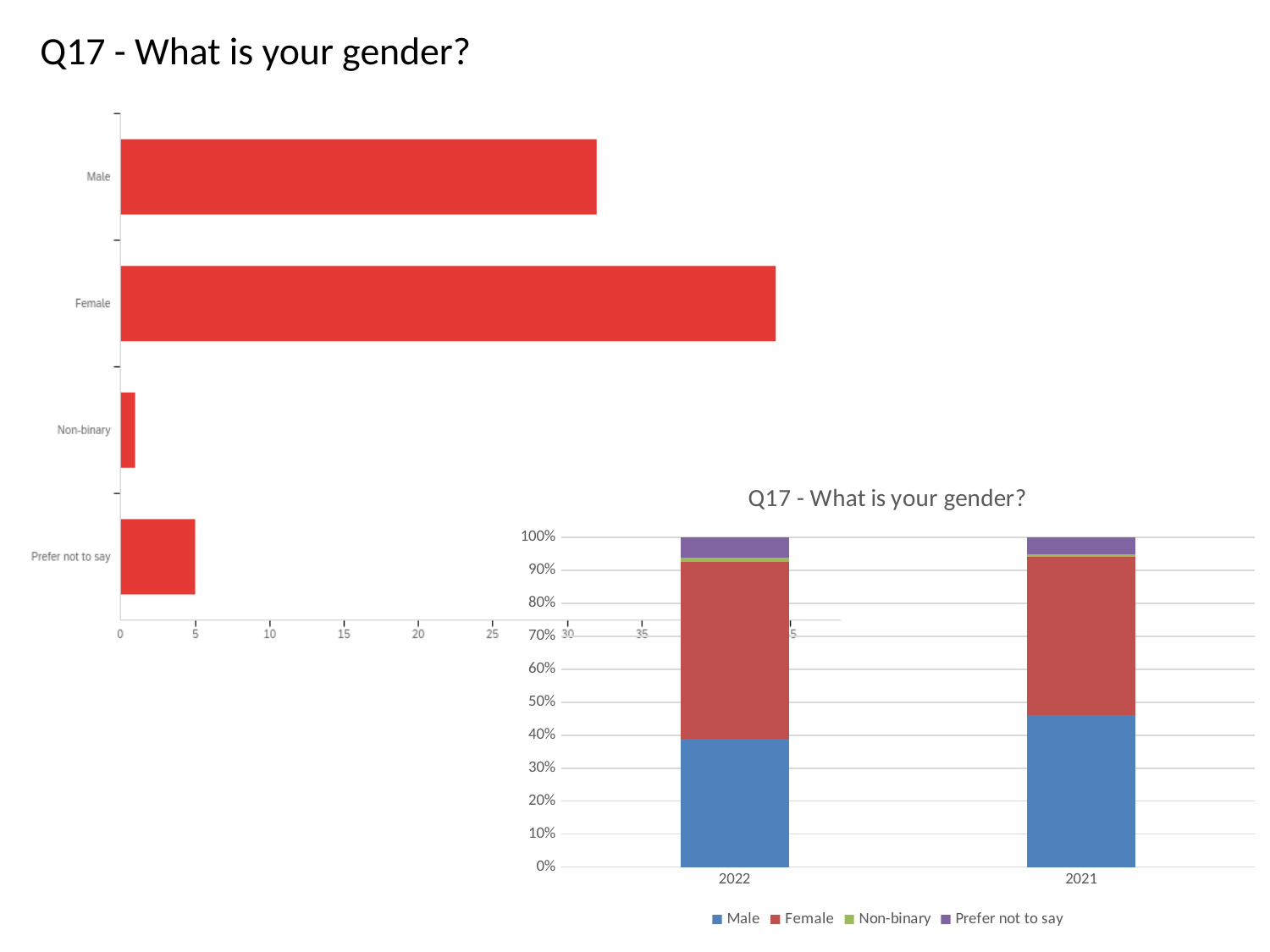
In the chart on the left of the slide, which category has the highest value? Female In the chart titled 'Q17 - What is your gender?' on the right of the slide, in which year is the Male share larger, 2022 or 2021? 2021 In the chart on the left of the slide, is the value for Female greater or less than 40? greater In the chart on the left of the slide, is the value for Male greater or less than 30? greater What kind of chart is the chart on the left of the slide? bar chart In the chart titled 'Q17 - What is your gender?' on the right of the slide, is the Male share for 2021 greater or less than 40%? greater What kind of chart is the chart titled 'Q17 - What is your gender?' on the right of the slide? stacked bar chart In the chart on the left of the slide, which is larger, the value for Male or the value for Female? Female In the chart on the left of the slide, what is the value for Prefer not to say? 5 How many series does the legend of the chart titled 'Q17 - What is your gender?' on the right of the slide list? 4 How many categories does the chart on the left of the slide show? 4 In the chart on the left of the slide, which category has the lowest value? Non-binary